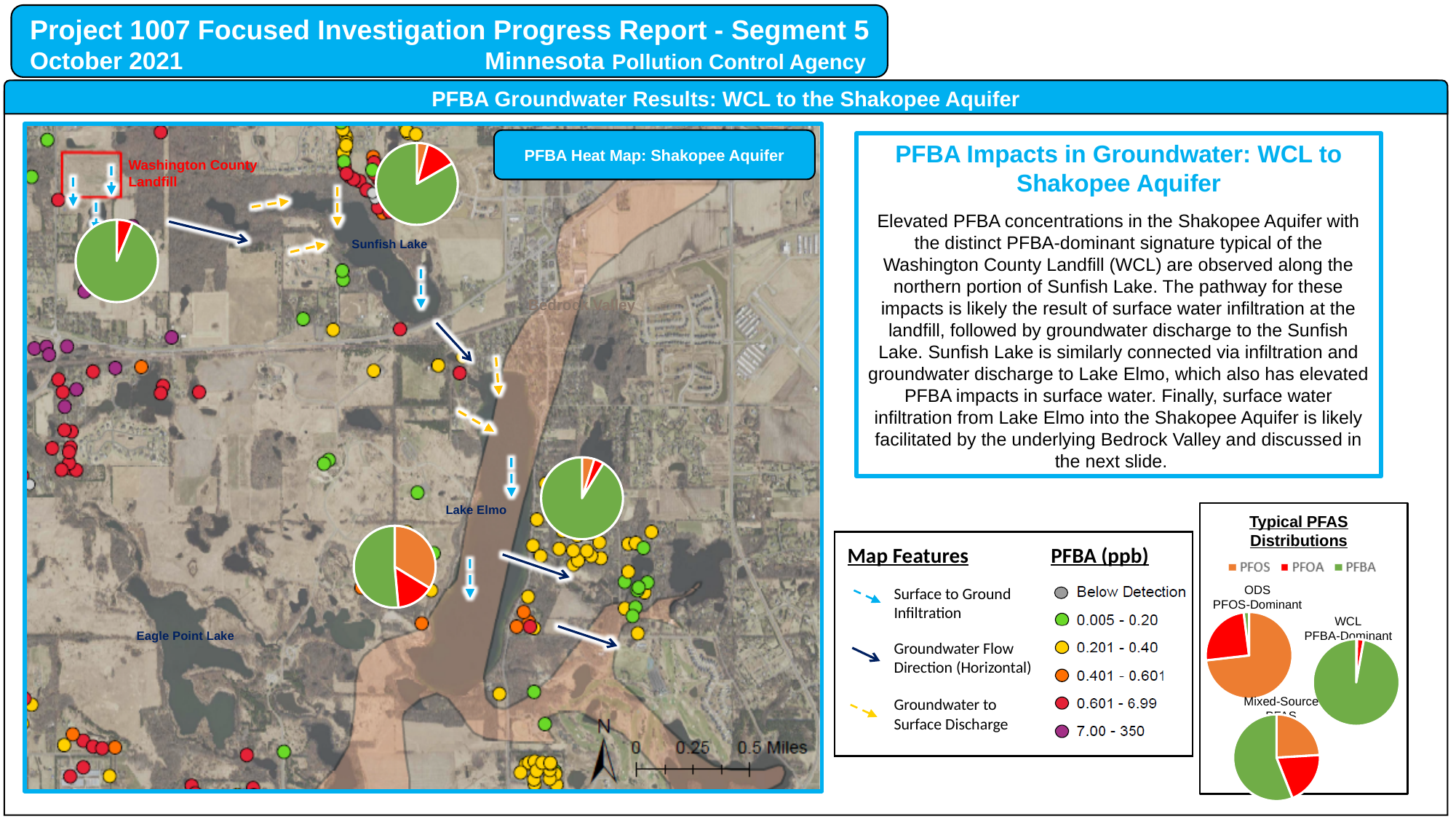
How many series does the legend in the 'Typical PFAS Distributions' box list? 3 In the 'WCL PFBA-Dominant' pie chart, which compound has the largest slice? PFBA In the 'Mixed-Source PFAS' pie chart, which compound has the largest slice? PFBA In the 'Typical PFAS Distributions' legend, what colour represents PFBA? green In the pie chart on the map next to Lake Elmo (to its left), which compound has the smallest slice? PFOA Which compounds are listed in the legend of the 'Typical PFAS Distributions' box? PFOS, PFOA, PFBA In the 'Typical PFAS Distributions' box, what kind of chart is used to show each distribution? pie chart In the 'ODS PFOS-Dominant' pie chart, which slice is larger, PFOS or PFOA? PFOS In the 'ODS PFOS-Dominant' pie chart, which compound has the smallest slice? PFBA In the 'WCL PFBA-Dominant' pie chart, which slice is larger, PFBA or PFOA? PFBA How many pie charts are shown inside the 'Typical PFAS Distributions' box? 3 In the 'ODS PFOS-Dominant' pie chart, which compound has the largest slice? PFOS